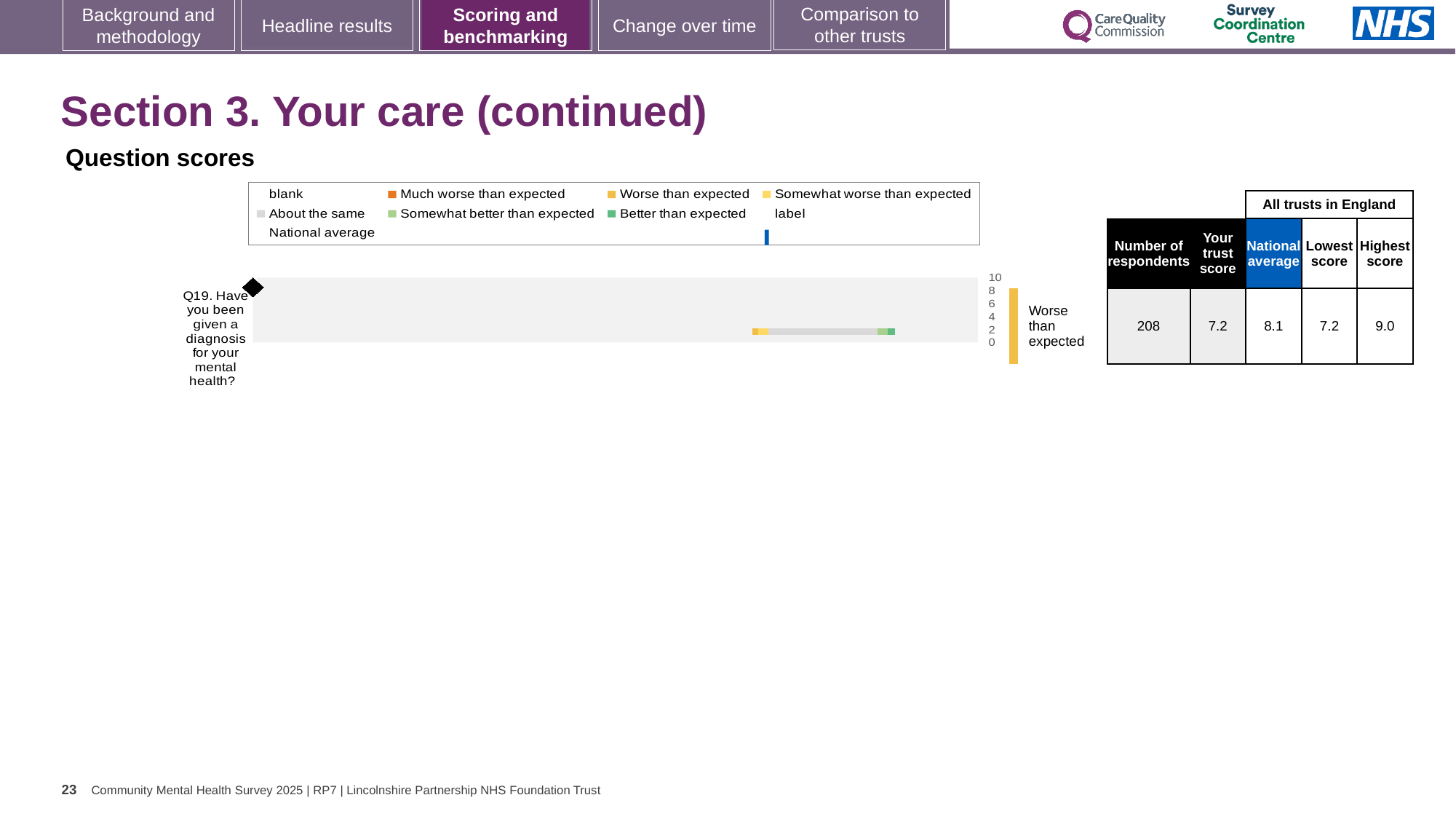
What is the number of respondents for Q19? 208 What is the difference between the highest and lowest scores for Q19? 1.8 What colour marks the national average in the chart legend? Blue What is the lowest score among all trusts in England for Q19? 7.2 What is the highest score among all trusts in England for Q19? 9.0 What is the national average score for Q19? 8.1 Which question is plotted in the question scores chart? Q19. Have you been given a diagnosis for your mental health? Which is larger for Q19, the trust score or the national average? National average What type of chart is used to show the question scores? Bar chart What is the trust score for Q19? 7.2 How many questions are plotted in the question scores chart? 1 What benchmarking category is shown for Q19? Worse than expected